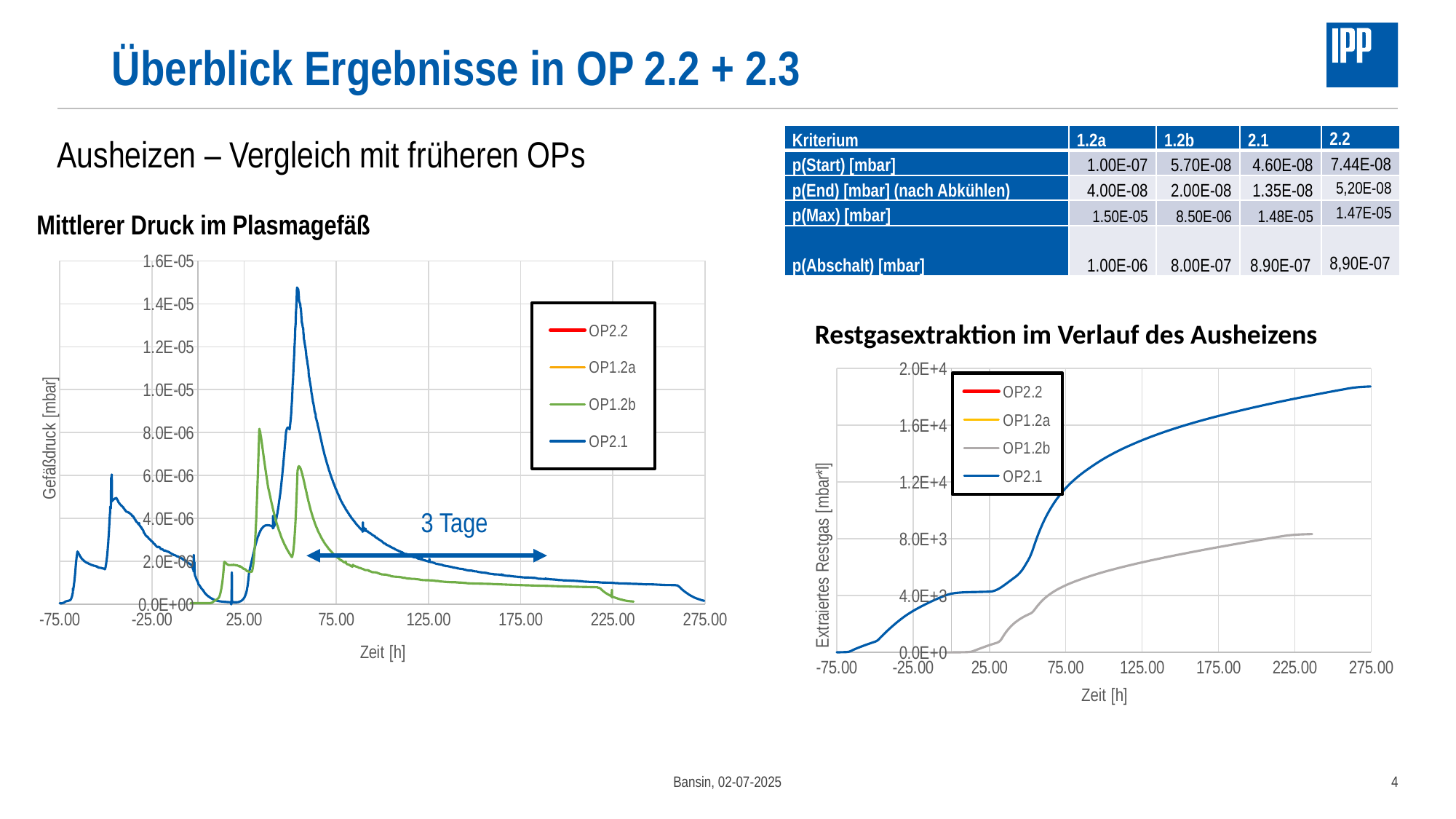
In the 'Mittlerer Druck im Plasmagefäß' chart, which series reaches the highest peak pressure? OP2.1 In the 'Mittlerer Druck im Plasmagefäß' chart, is the peak value of OP2.1 greater or less than 1.2E-05? greater In the 'Restgasextraktion im Verlauf des Ausheizens' chart, is the final value of OP2.1 at 275 h greater or less than 1.6E+4? greater What kind of chart is the 'Restgasextraktion im Verlauf des Ausheizens' chart? line chart How many series does the legend of the 'Restgasextraktion im Verlauf des Ausheizens' chart list? 4 In the 'Restgasextraktion im Verlauf des Ausheizens' chart, does the OP2.1 curve rise or fall along the x axis? rise In the 'Mittlerer Druck im Plasmagefäß' chart, is the peak value of OP1.2b greater or less than 1.0E-05? less What is the x-axis label of the 'Mittlerer Druck im Plasmagefäß' chart? Zeit [h] What kind of chart is the 'Mittlerer Druck im Plasmagefäß' chart? line chart In the 'Restgasextraktion im Verlauf des Ausheizens' chart, which series has the larger value at 225 h, OP2.1 or OP1.2b? OP2.1 How many series does the legend of the 'Mittlerer Druck im Plasmagefäß' chart list? 4